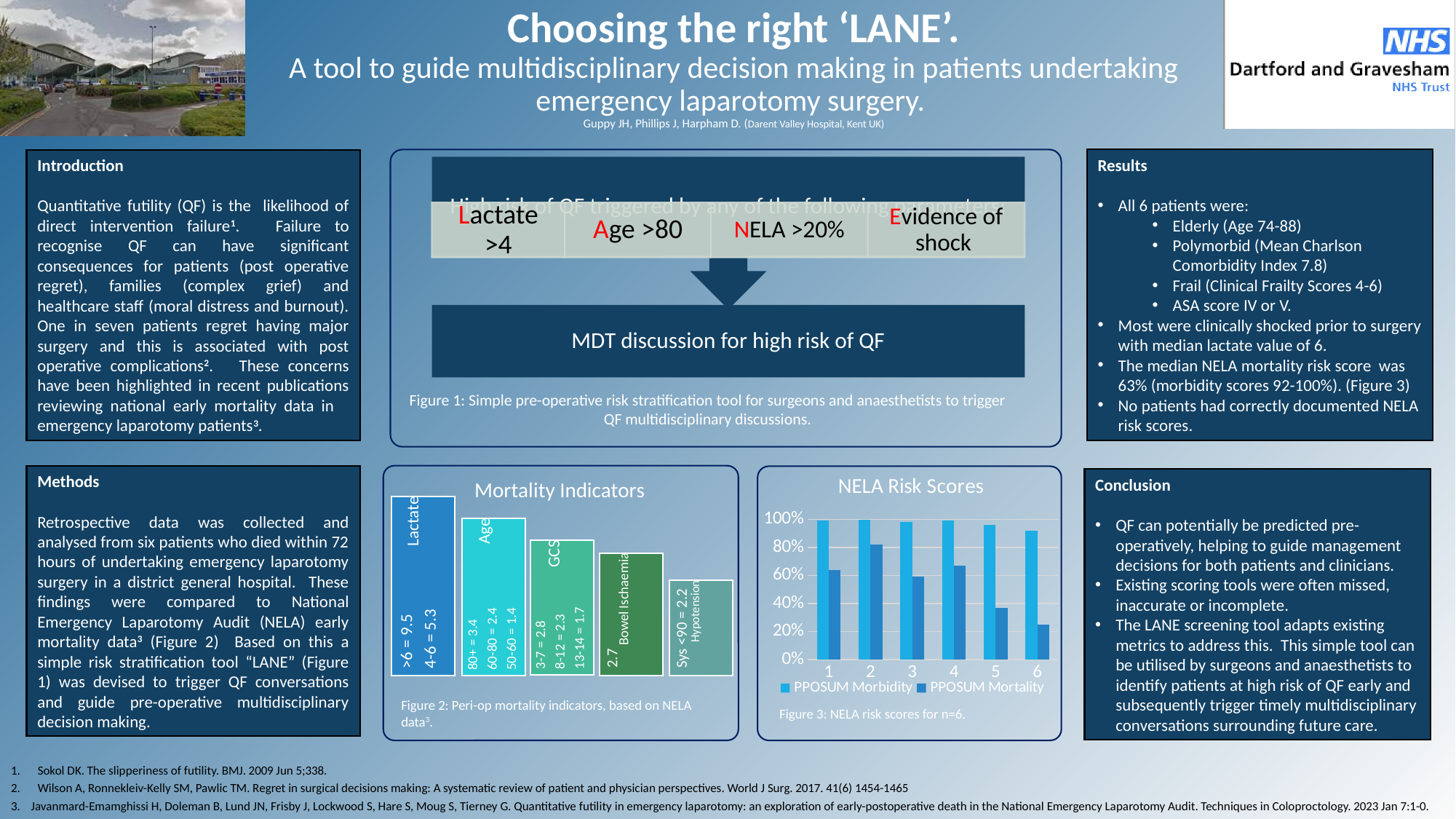
In the 'NELA Risk Scores' chart, which patient has the larger PPOSUM Mortality value, patient 2 or patient 5? 2 What are the two legend entries of the 'NELA Risk Scores' chart? PPOSUM Morbidity and PPOSUM Mortality What kind of chart is the 'NELA Risk Scores' chart? bar chart In the 'NELA Risk Scores' chart, which patient has the lowest PPOSUM Mortality value? 6 In the 'NELA Risk Scores' chart, is the PPOSUM Mortality value for patient 2 greater or less than 60%? greater In the 'NELA Risk Scores' chart, do the PPOSUM Mortality values rise or fall from patient 4 to patient 6? fall How many patients (categories) are shown on the x axis of the 'NELA Risk Scores' chart? 6 How many series does the legend of the 'NELA Risk Scores' chart list? 2 In the 'NELA Risk Scores' chart, is the PPOSUM Morbidity value for patient 6 greater or less than 80%? greater In the 'NELA Risk Scores' chart, which is larger for patient 6: PPOSUM Morbidity or PPOSUM Mortality? PPOSUM Morbidity In the 'NELA Risk Scores' chart, which patient has the highest PPOSUM Mortality value? 2